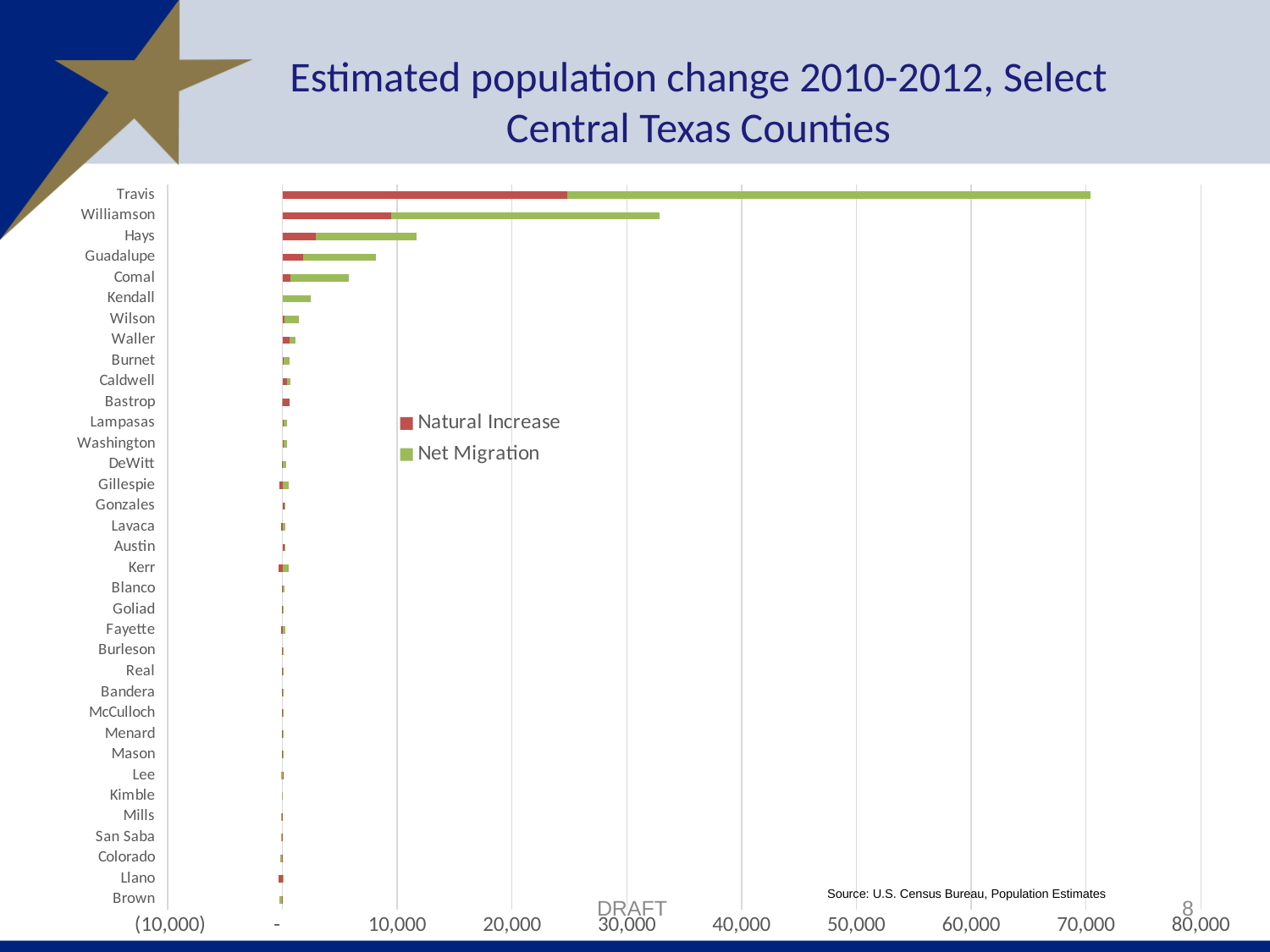
Is the Natural Increase value for Travis greater or less than 20,000? greater How many series does the legend list? 2 Is the total value for Travis greater or less than 60,000? greater What is the title of the chart? Estimated population change 2010-2012, Select Central Texas Counties How many counties are listed on the chart? 35 What kind of chart is shown on the slide? bar chart Which county has the larger total population change, Travis or Williamson? Travis Which county has the largest total estimated population change? Travis Is the total value for Williamson greater or less than 30,000? greater What are the two series named in the legend? Natural Increase and Net Migration Which county has the larger total population change, Hays or Guadalupe? Hays